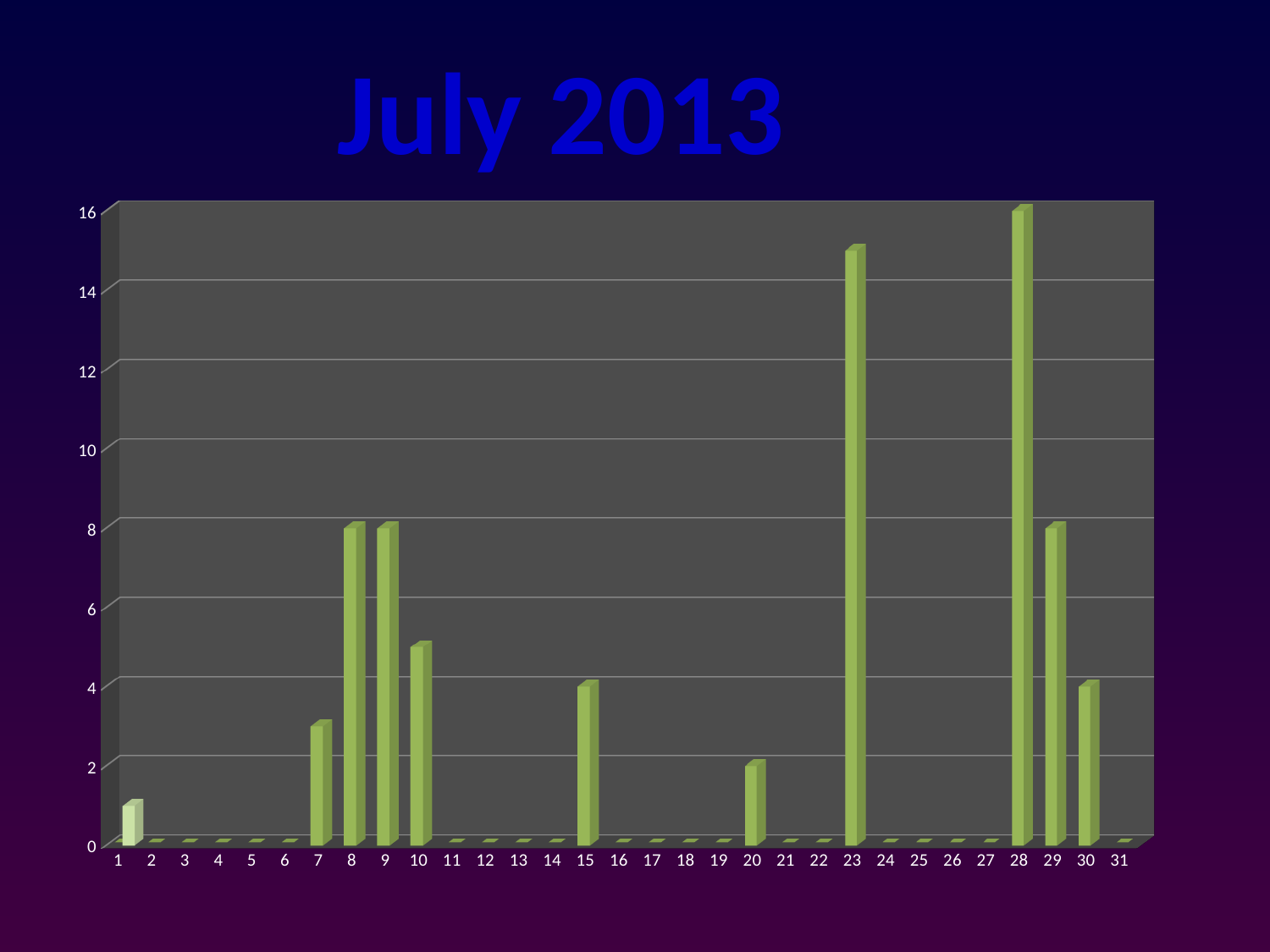
Is the value for day 23 greater or less than 14? greater What is the value for day 28? 16 What is the value for day 20? 2 Is the value for day 7 greater or less than 4? less What is the title of the chart? July 2013 What is the value for day 8? 8 Which has the larger value, day 23 or day 15? day 23 Which day has the highest value? 28 How many days are shown on the x axis? 31 What is the value for day 15? 4 What kind of chart is shown on the slide? bar chart Is the value for day 10 greater or less than 4? greater